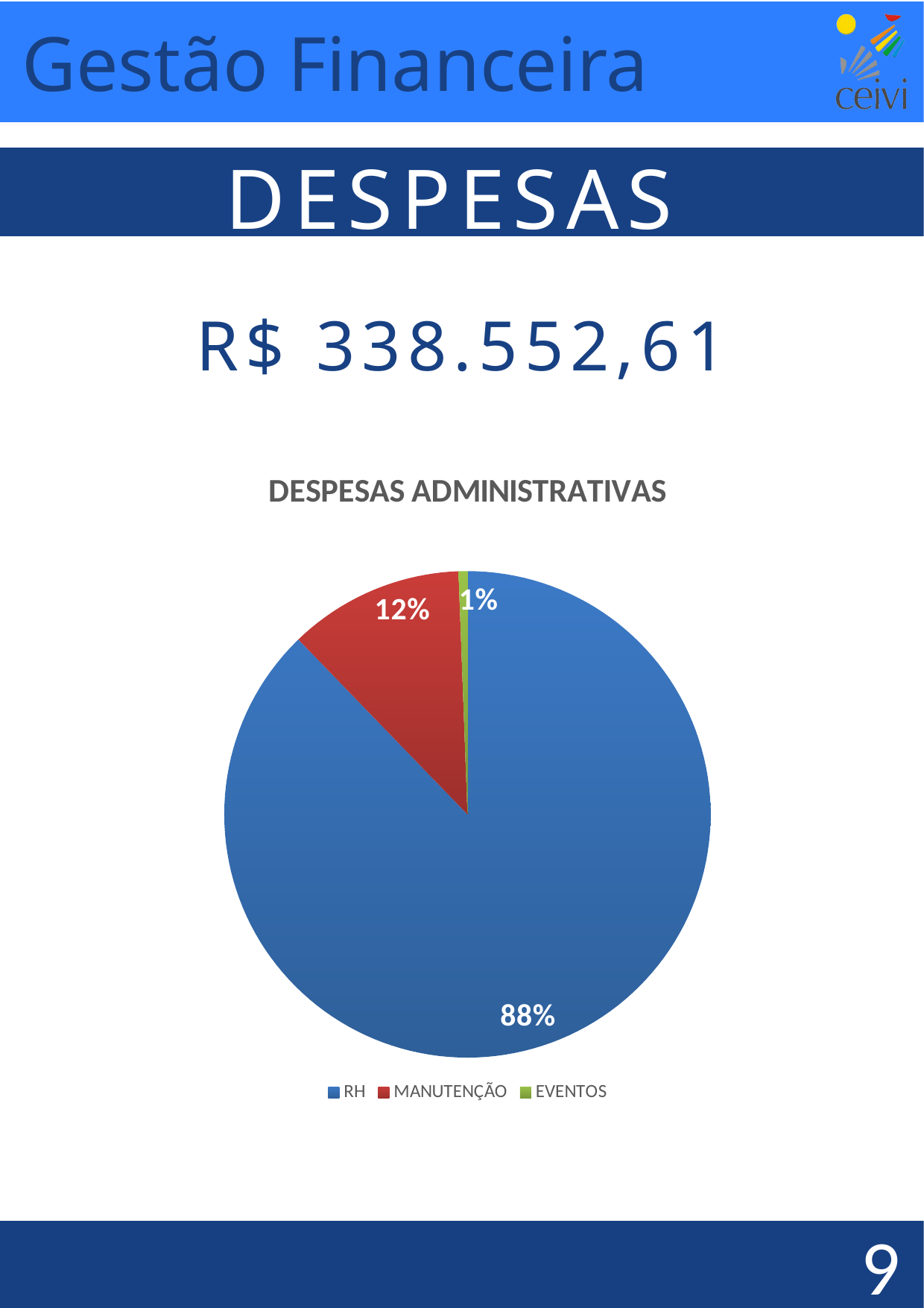
Which category has the largest slice of the pie? RH What share of the pie does RH represent? 88% What kind of chart is shown on the slide? pie chart What share of the pie does MANUTENÇÃO represent? 12% What share of the pie does EVENTOS represent? 1% Which category has the smallest slice of the pie? EVENTOS How many entries does the legend list? 3 What colour is the MANUTENÇÃO slice? red What is the title of the chart? DESPESAS ADMINISTRATIVAS How many categories does the pie chart show? 3 Which is larger, the MANUTENÇÃO slice or the EVENTOS slice? MANUTENÇÃO What is the difference in percentage points between the RH slice and the MANUTENÇÃO slice? 76